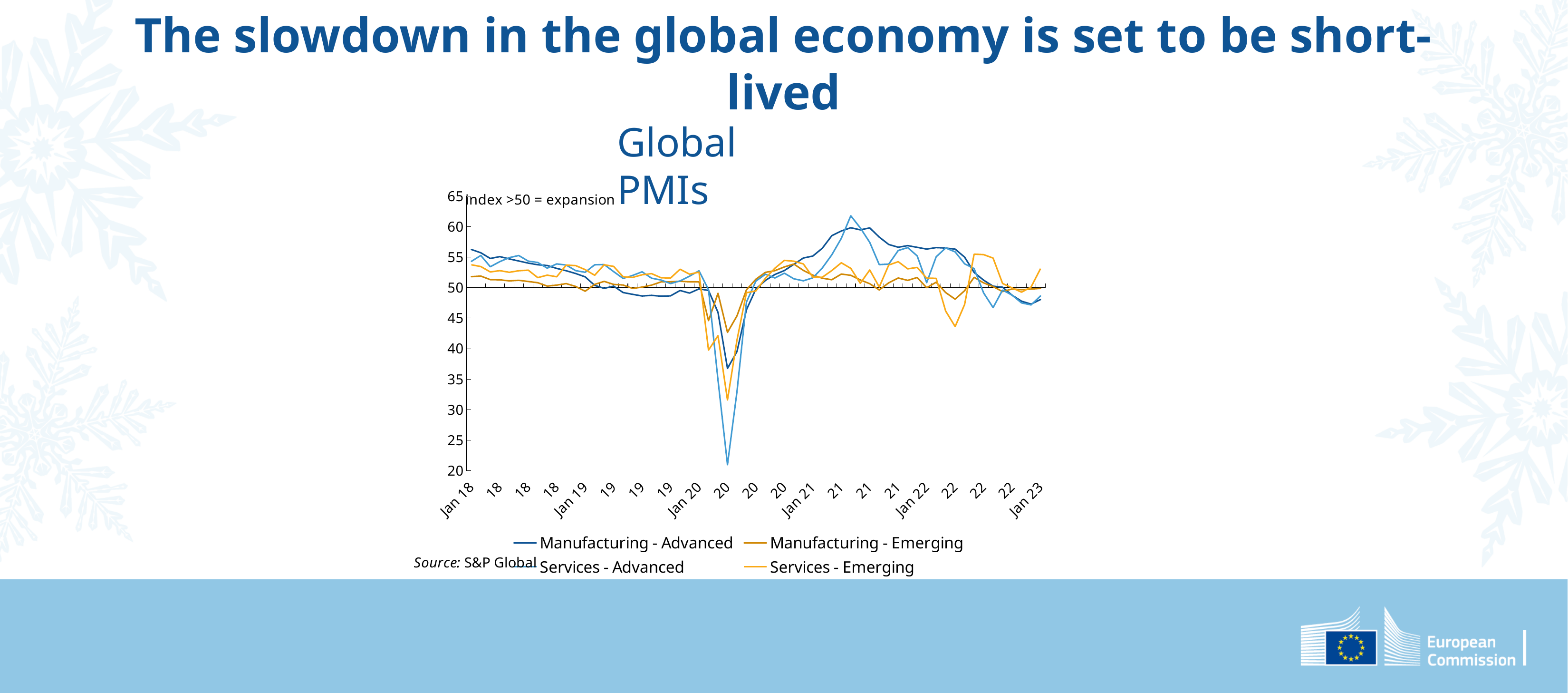
Which series reaches the highest peak on the chart during 2021? Services - Advanced What kind of chart is shown on the slide? line chart Which series falls to the lowest point on the chart during 2020? Services - Advanced Does the Manufacturing - Advanced series rise or fall between Jan 22 and Jan 23? fall According to the legend, which series is drawn in dark blue? Manufacturing - Advanced Is the lowest value of Services - Advanced in 2020 greater or less than 25? less Is the value for Services - Emerging at Jan 23 greater or less than 50? greater Is the lowest value of Manufacturing - Advanced in 2020 greater or less than 40? less How many series does the legend of the Global PMIs chart list? 4 What is the highest value shown on the vertical axis of the chart? 65 What is the title of the chart on the slide? Global PMIs